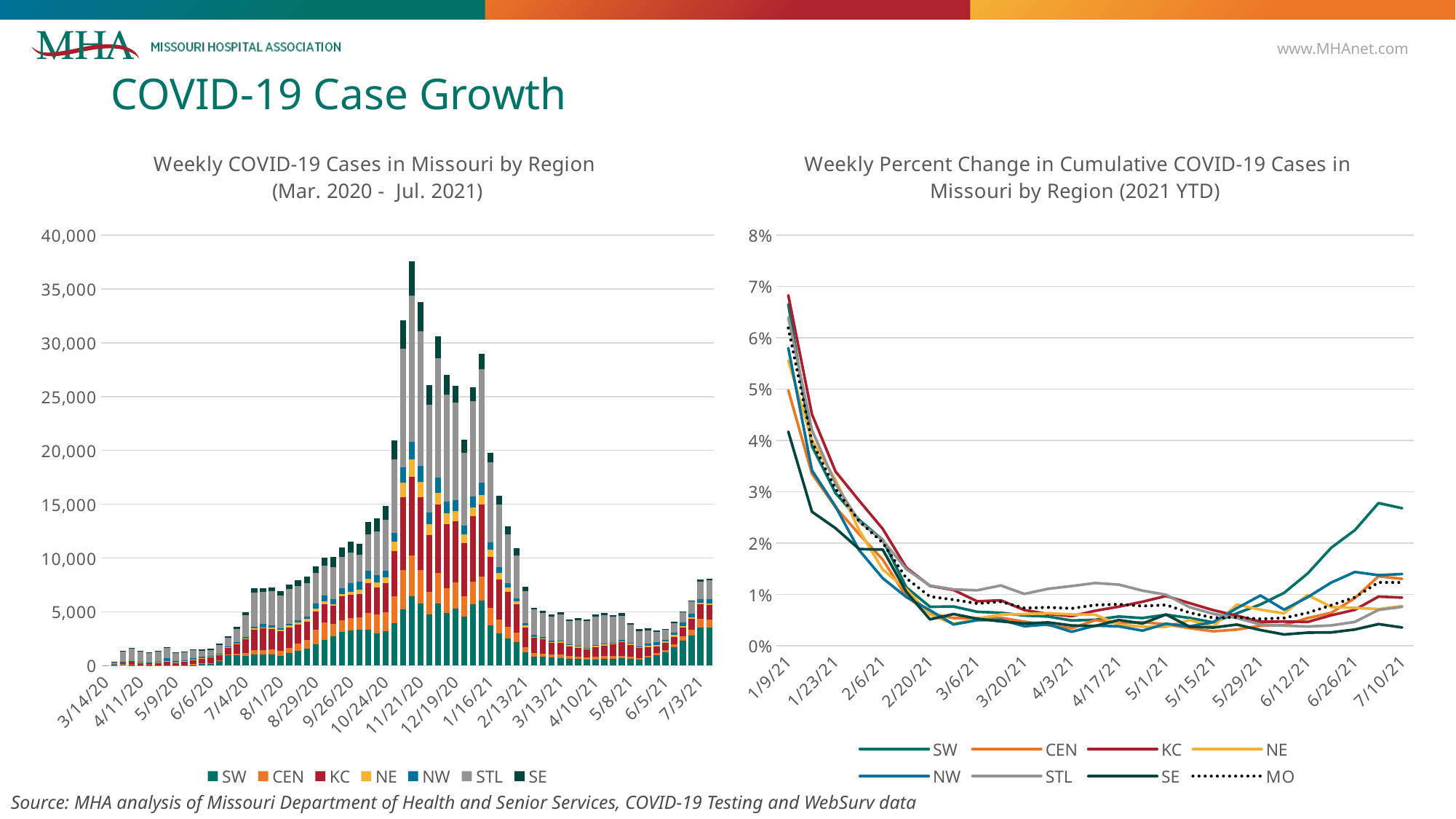
In the right chart, do the lines generally rise or fall from 1/9/21 to 2/20/21? fall How many series does the legend of the left chart list? 7 In the right chart, which region has the lowest weekly percent change at 7/10/21? SE In the right chart, is the value for SW at 7/10/21 greater or less than 2%? greater What kind of chart is the left chart, 'Weekly COVID-19 Cases in Missouri by Region'? Stacked bar chart In the right chart, which region has the highest weekly percent change at 7/10/21? SW How many series does the legend of the right chart list? 8 In the left chart, is the tallest weekly total greater or less than 35,000? greater In the right chart, which series is drawn as a dotted line? MO What kind of chart is the right chart, 'Weekly Percent Change in Cumulative COVID-19 Cases in Missouri by Region'? Line chart In the left chart, which region makes up the largest portion of the tallest bar? STL In the right chart, is the value for SE at 1/9/21 greater or less than 5%? less